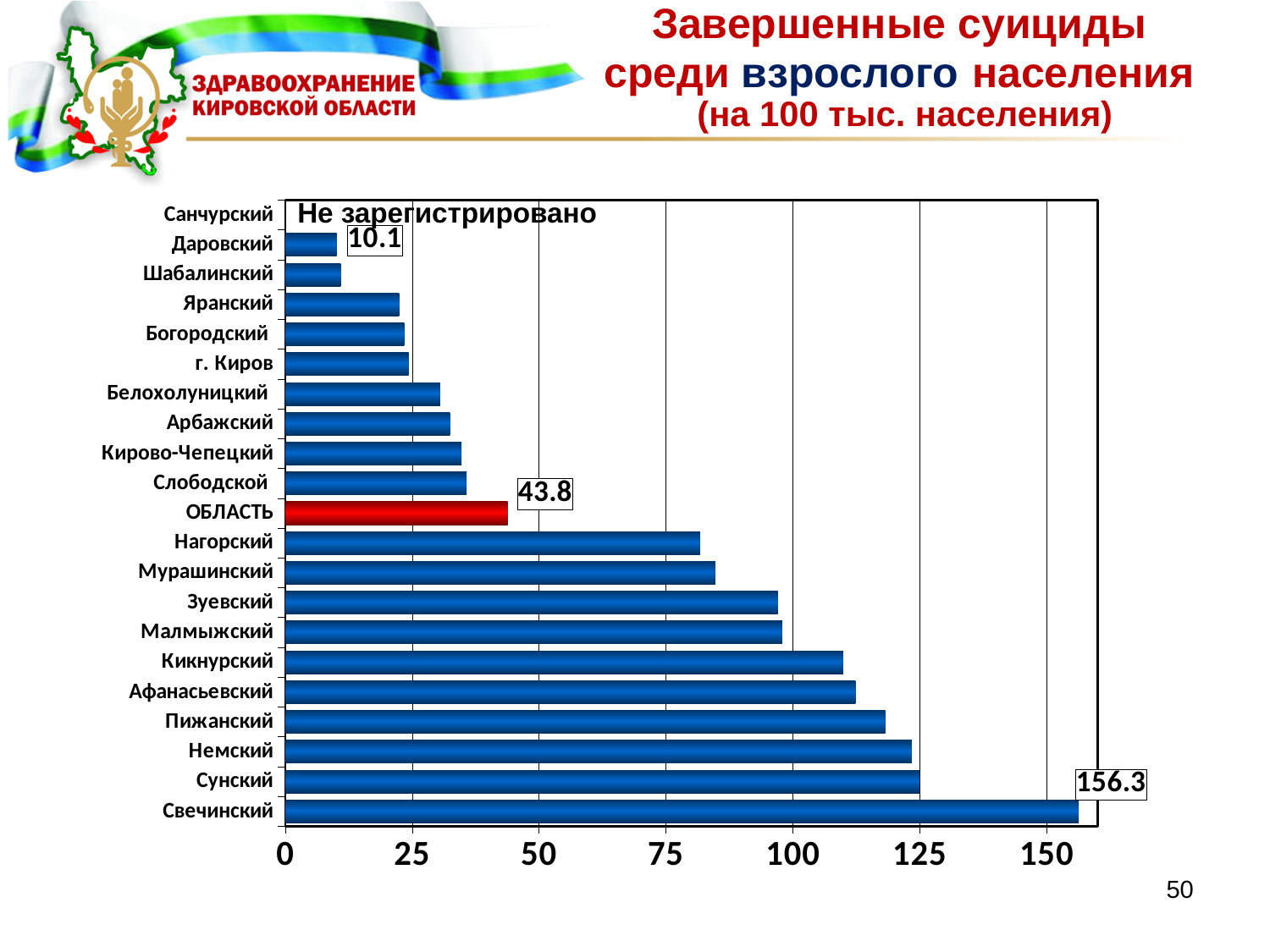
What is the value for ОБЛАСТЬ? 43.8 What is the difference between the values for ОБЛАСТЬ and Даровский? 33.7 Is the value for Сунский greater or less than 100? greater What kind of chart is shown on the slide? bar chart What is the value for Даровский? 10.1 Is the value for Нагорский greater or less than 100? less Is the value for Белохолуницкий greater or less than 25? greater What is the difference between the values for Свечинский and ОБЛАСТЬ? 112.5 Which has a larger value, Нагорский or Слободской? Нагорский What is the value for Свечинский? 156.3 What text is shown in place of a bar for Санчурский? Не зарегистрировано Which category has the highest value? Свечинский